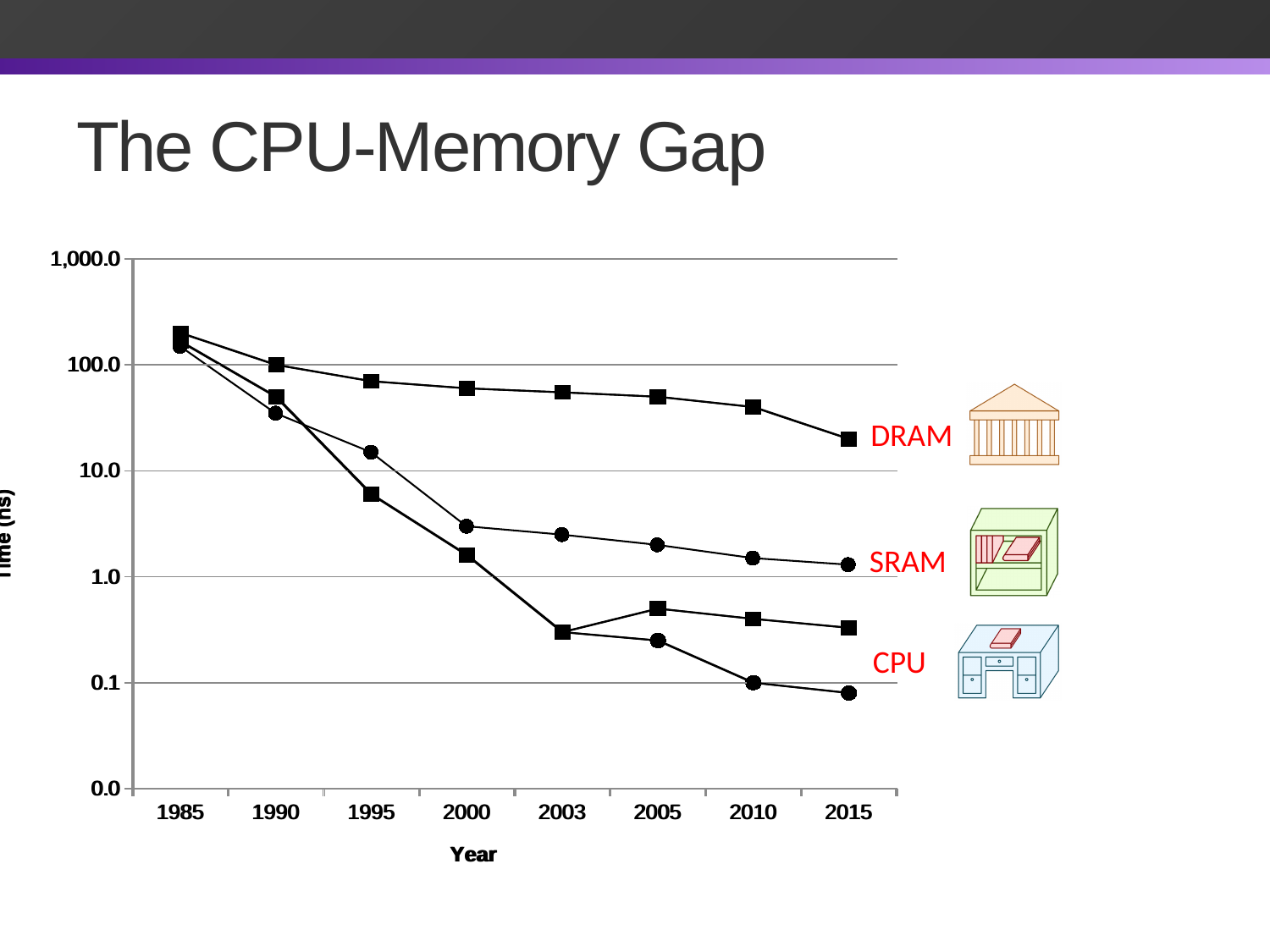
Which series has the highest value in 2015? DRAM What is the title of the chart on the slide? The CPU-Memory Gap What is the label of the x axis? Year In 2015, which is larger, the DRAM value or the SRAM value? DRAM How many years are marked along the x axis? 8 Is the SRAM value in 2015 greater or less than 1.0? greater Which series has the lowest value in 2015? CPU Does the DRAM line rise or fall from 1985 to 2015? fall Is the SRAM value in 1995 greater or less than 10.0? greater Is the DRAM value in 2015 greater or less than 10.0? greater What kind of chart is shown on the slide? line chart